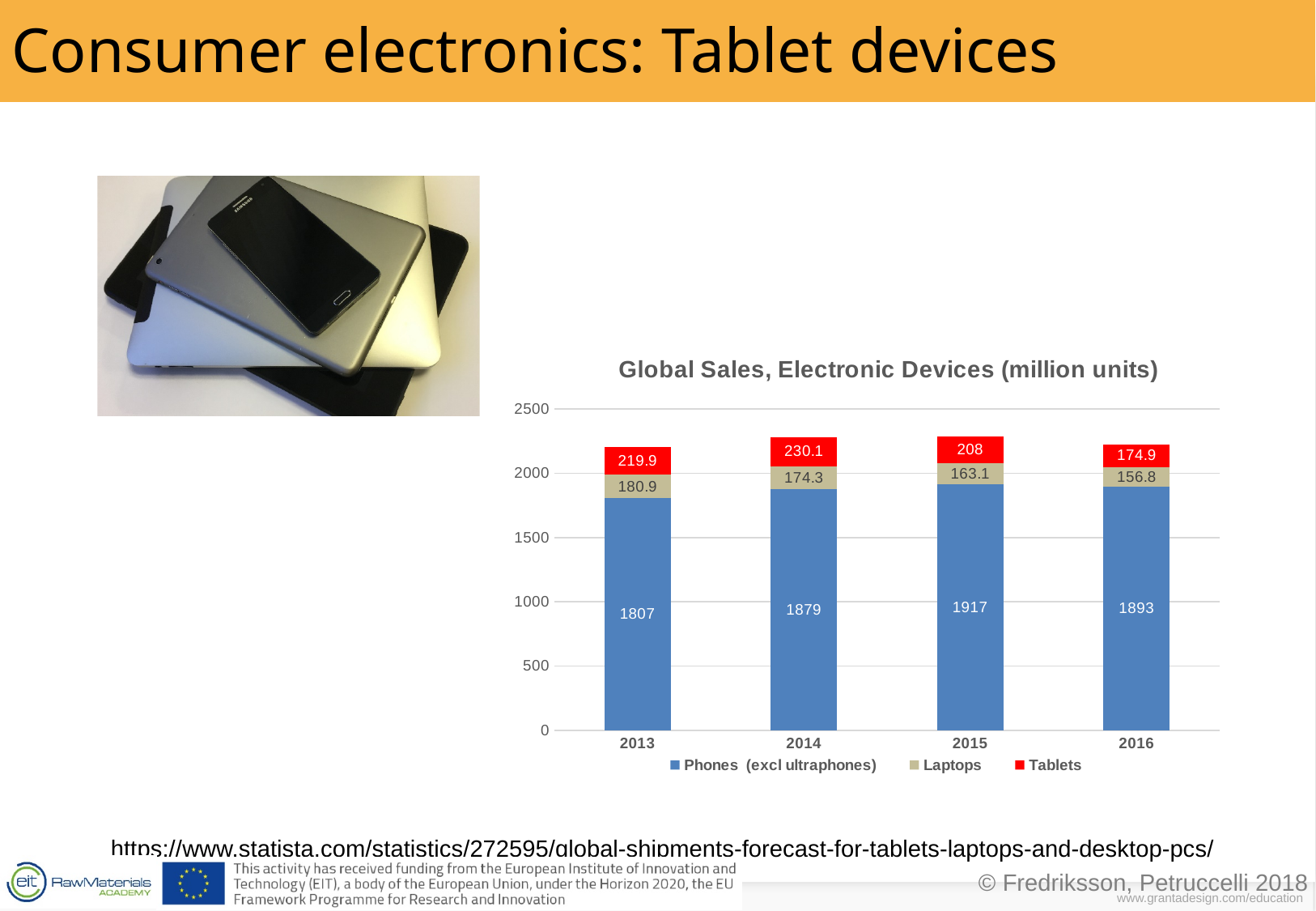
In which year is the Laptops value lowest? 2016 What is the total of the stacked bar for 2013? 2207.8 What is the difference between the Tablets values for 2014 and 2016? 55.2 What is the value for Laptops in 2016? 156.8 Which is larger, the Phones (excl ultraphones) value in 2013 or in 2016? 2016 What is the value for Tablets in 2014? 230.1 In which year is the Tablets value highest? 2014 What is the value for Phones (excl ultraphones) in 2015? 1917 How many series does the legend list? 3 What kind of chart is shown on the slide? Stacked bar chart Do the Laptops values rise or fall from 2013 to 2016? Fall How many years are shown on the x axis? 4